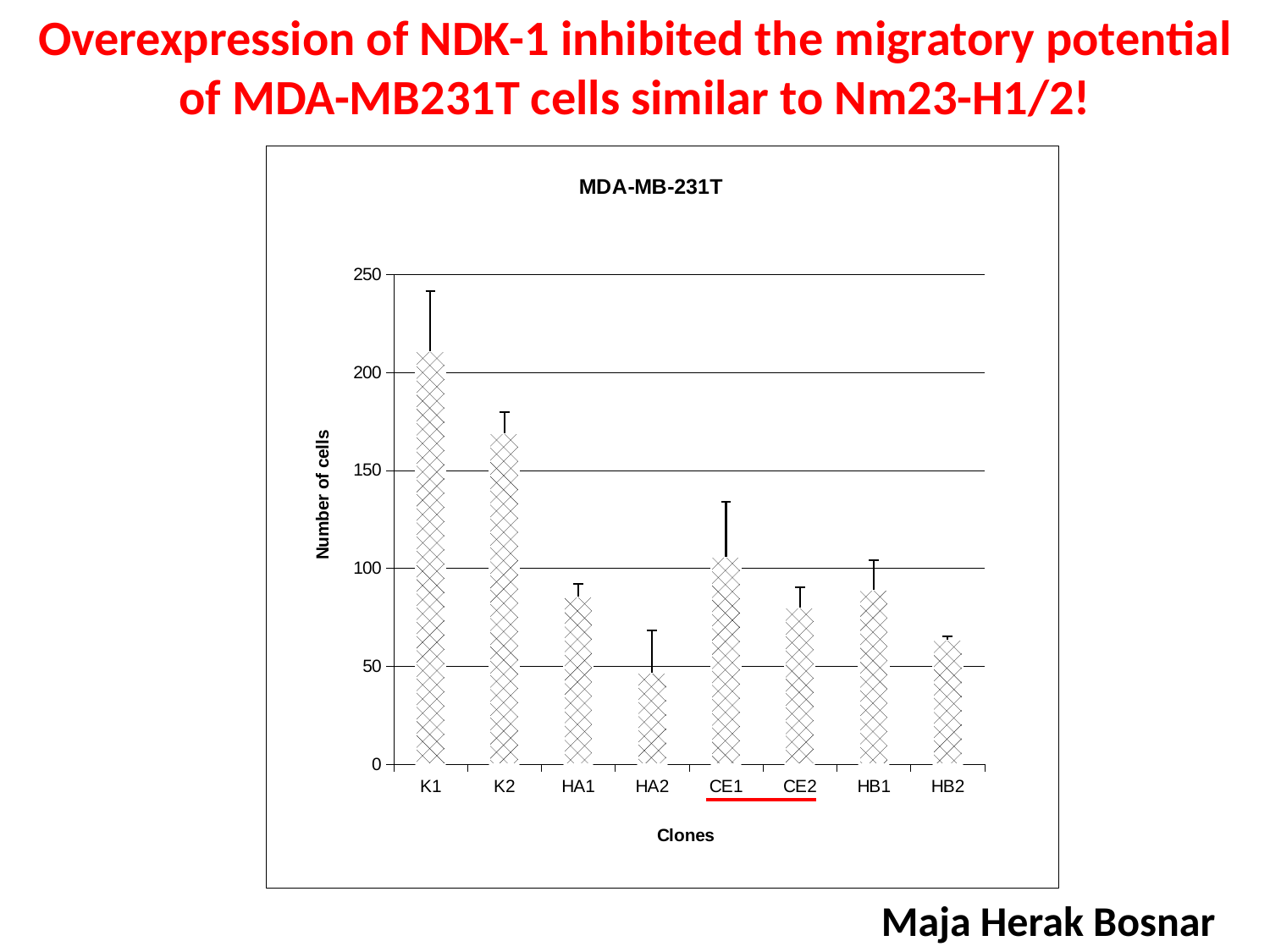
How many clones are plotted on the x axis of the chart? 8 Is the value for K2 greater or less than 150? greater Is the value for K1 greater or less than 200? greater Is the value for HB2 greater or less than 50? greater What is the title of the chart? MDA-MB-231T What kind of chart is shown on the slide? bar chart Which is larger, the value for K1 or the value for K2? K1 Which is larger, the value for HA2 or the value for CE1? CE1 Which clone has the lowest number of cells? HA2 Which clone has the highest number of cells? K1